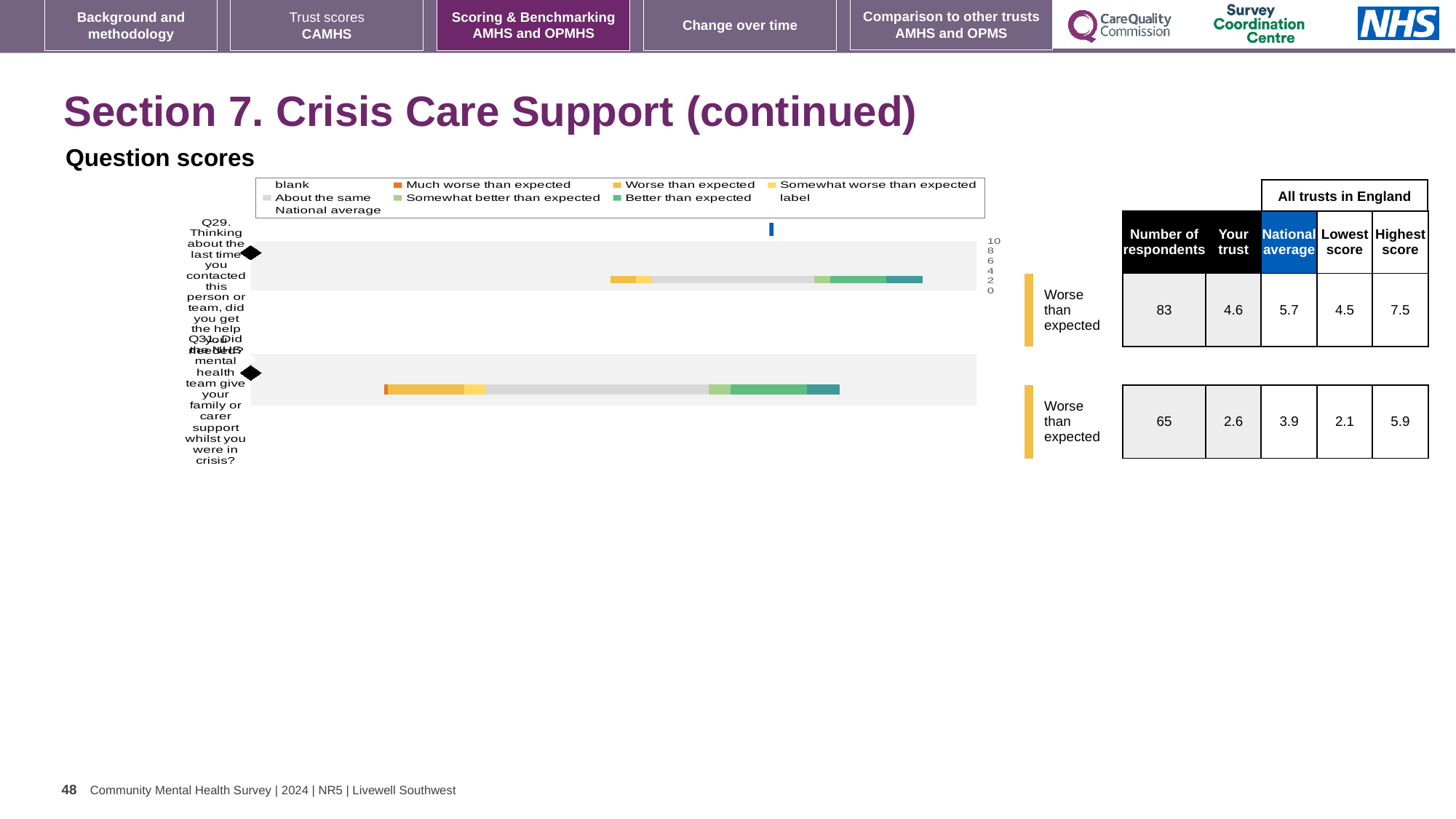
In the question scores chart, which question has the higher 'Your trust' score, Q29 or Q31? Q29 How many questions (bars) are plotted in the question scores chart? 2 In the question scores chart, what is the highest score across all trusts in England for Q31? 5.9 In the question scores chart, what benchmark rating label is shown for Q29? Worse than expected In the question scores chart, what is the difference between the highest score and the lowest score for Q29? 3.0 In the question scores chart, what is the number of respondents for Q29? 83 In the question scores chart, what is the 'Your trust' score for Q31? 2.6 What kind of chart is used to show the question scores for Q29 and Q31? bar chart In the question scores chart, what is the national average for Q29? 5.7 In the question scores chart, what is the difference between the national average and the 'Your trust' score for Q31? 1.3 In the question scores chart, what is the lowest score across all trusts in England for Q31? 2.1 In the question scores chart, what is the 'Your trust' score for Q29? 4.6